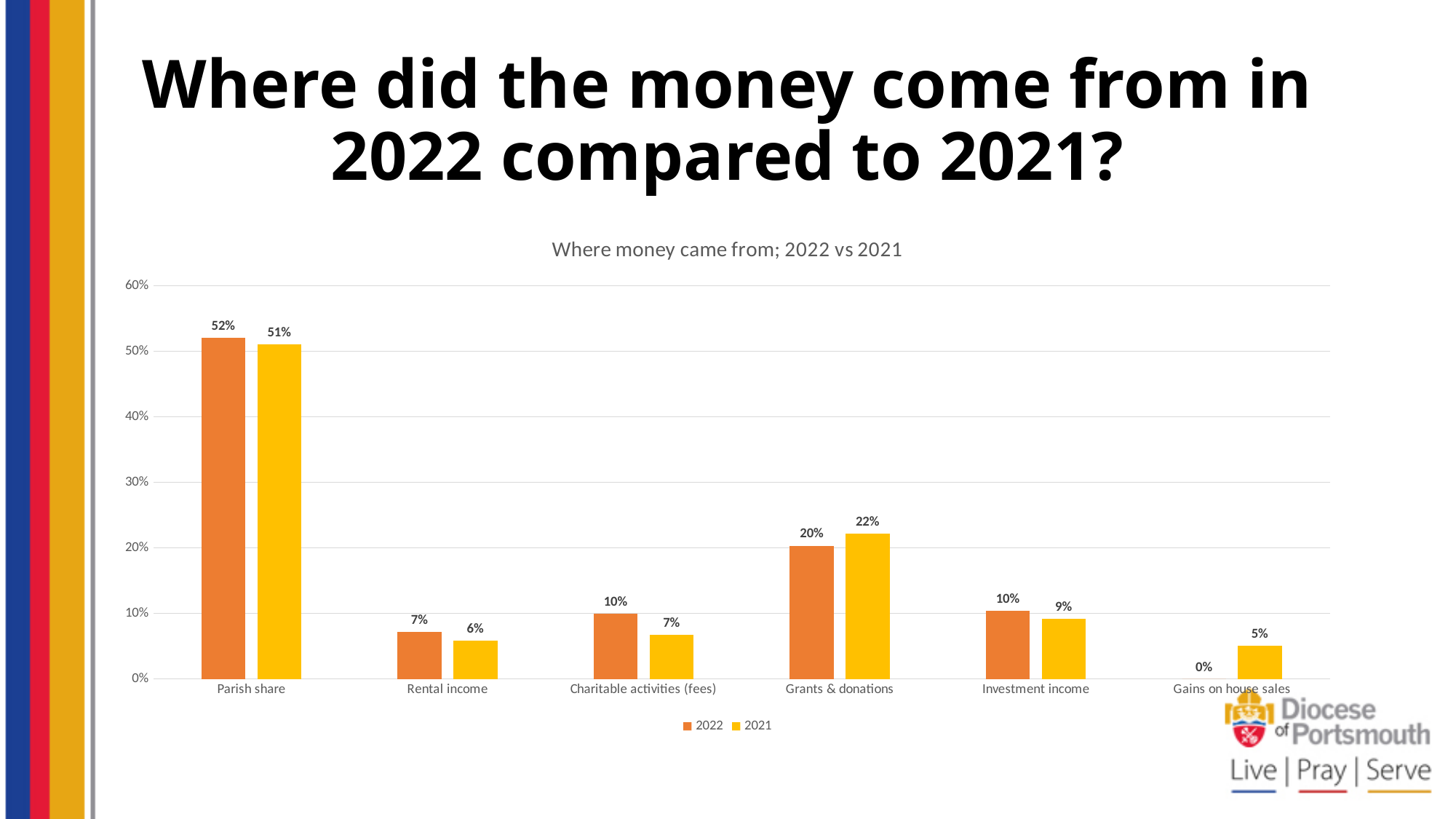
What is the title of the chart? Where money came from; 2022 vs 2021 Which category has the lowest 2021 value? Gains on house sales What kind of chart is shown on the slide? Bar chart How many series does the legend list? 2 Which category has the highest 2022 value? Parish share What is the 2022 value for Gains on house sales? 0% What is the difference between the 2022 and 2021 values for Charitable activities (fees)? 3% How many categories are shown on the x axis? 6 What is the 2021 value for Grants & donations? 22% For Grants & donations, which year has the larger value, 2022 or 2021? 2021 What is the 2021 value for Investment income? 9% What is the 2022 value for Parish share? 52%